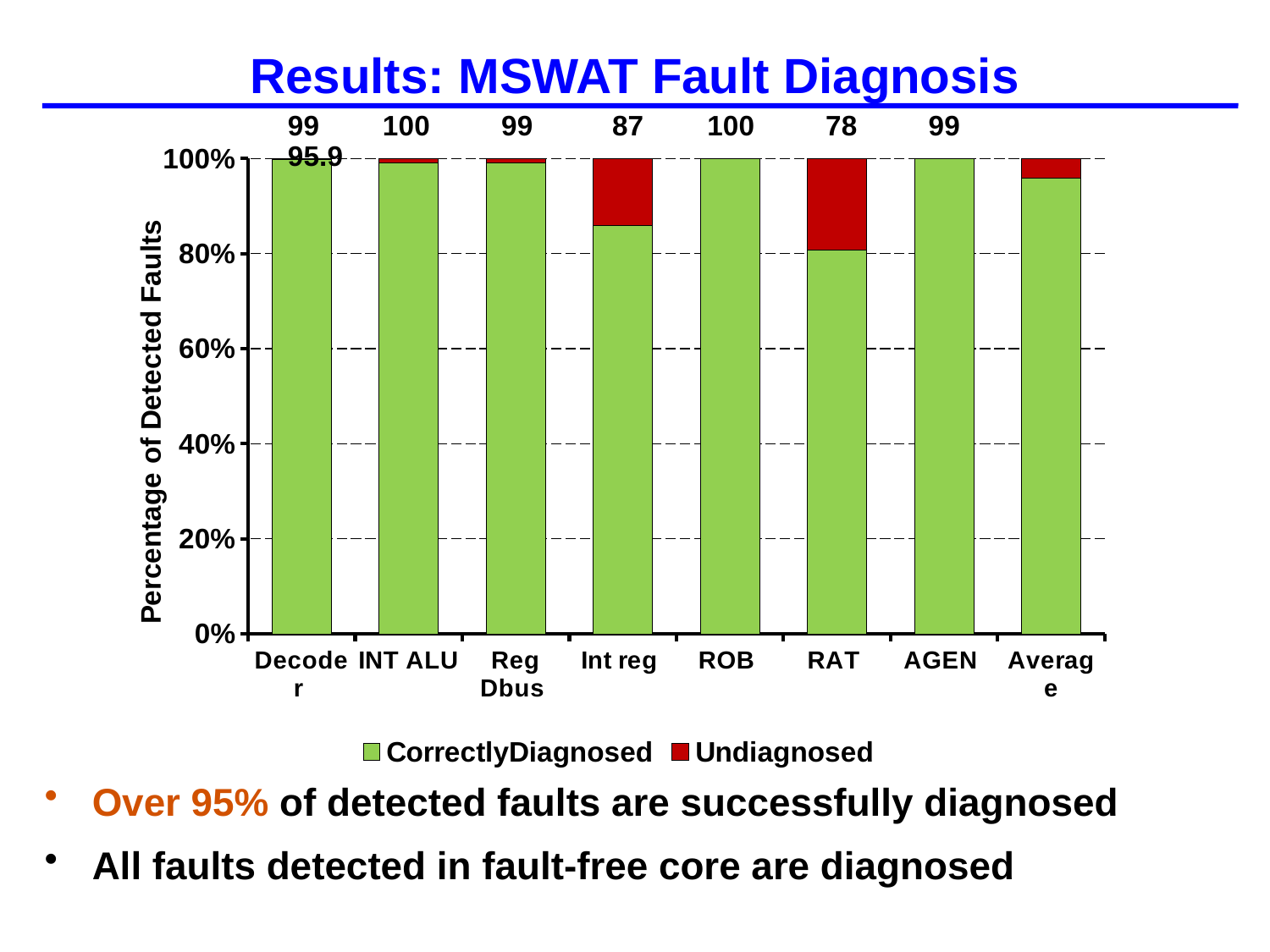
Which category has the lowest labelled value? RAT Which has a larger labelled value, Int reg or RAT? Int reg How many series does the legend list? 2 How many categories are shown along the x axis? 8 What is the labelled value for Int reg? 87 What kind of chart is shown on the slide? bar chart What is the labelled value for Decoder? 99 What are the two legend entries? CorrectlyDiagnosed and Undiagnosed Which category has the largest Undiagnosed portion? RAT What is the difference between the labelled values for Int reg and RAT? 9 What is the labelled value for RAT? 78 Is the CorrectlyDiagnosed value for Int reg greater or less than 80%? greater